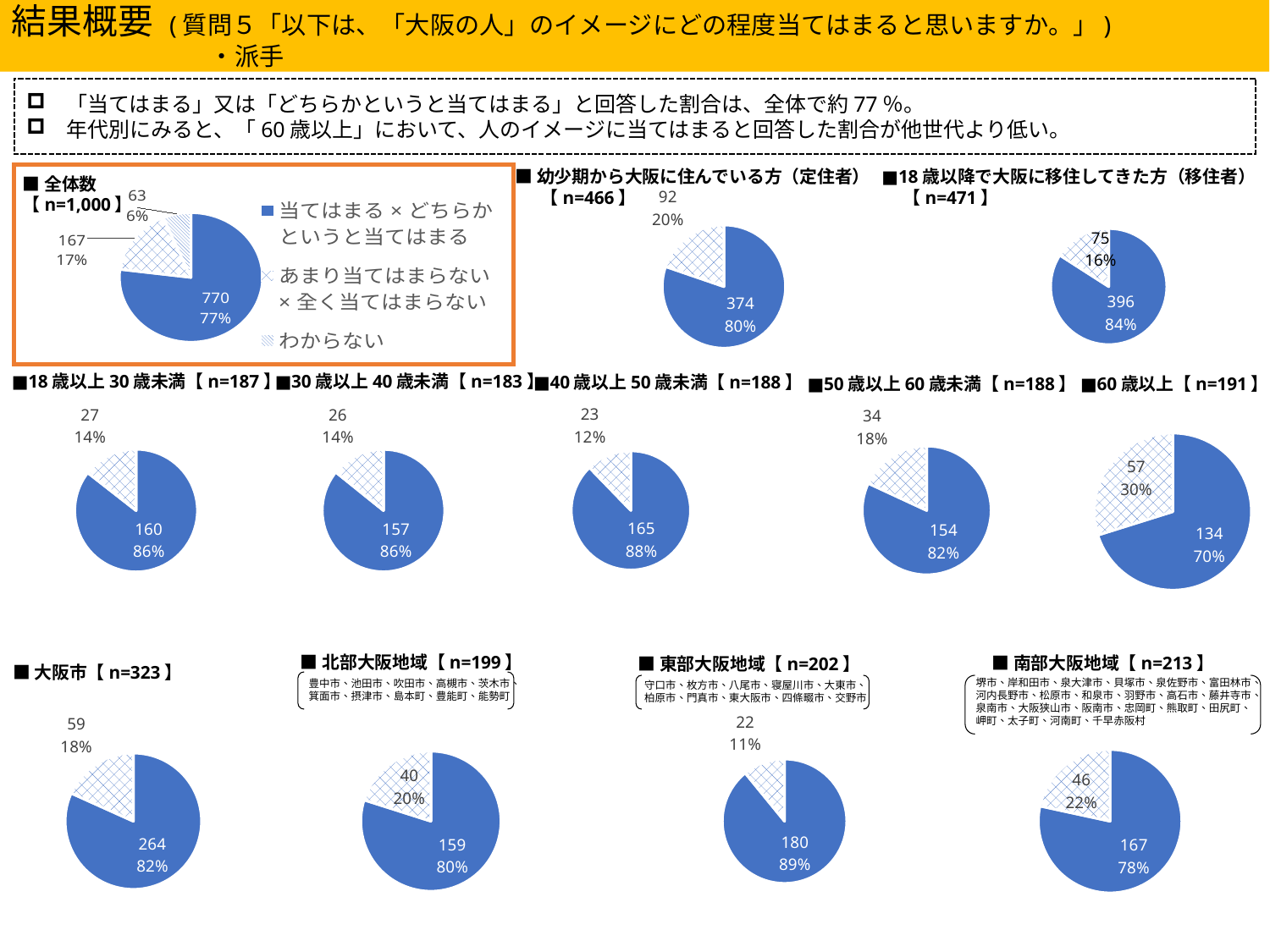
「幼少期から大阪に住んでいる方（定住者）【n=466】」の円グラフで、「当てはまる×どちらかというと当てはまる」の割合は何%ですか。 80% 「全体数【n=1,000】」の円グラフで、「あまり当てはまらない×全く当てはまらない」の割合は何%ですか。 17% 「全体数【n=1,000】」の円グラフの凡例には、いくつの項目がありますか。 3 「大阪市【n=323】」の円グラフで、「あまり当てはまらない×全く当てはまらない」の値はいくつですか。 59 「40歳以上50歳未満【n=188】」の円グラフで、「当てはまる×どちらかというと当てはまる」の値と「あまり当てはまらない×全く当てはまらない」の値の差はいくつですか。 142 「北部大阪地域【n=199】」の円グラフで、「当てはまる×どちらかというと当てはまる」の値はいくつですか。 159 「全体数【n=1,000】」の円グラフで、最も小さい区分の値はいくつですか。 63 「60歳以上【n=191】」の円グラフで、「当てはまる×どちらかというと当てはまる」の割合は何%ですか。 70% 「東部大阪地域【n=202】」と「南部大阪地域【n=213】」の円グラフで、「当てはまる×どちらかというと当てはまる」の割合が大きいのはどちらですか。 東部大阪地域 「全体数【n=1,000】」の円グラフで、「当てはまる×どちらかというと当てはまる」の値はいくつですか。 770 「18歳以降で大阪に移住してきた方（移住者）【n=471】」の円グラフで、「あまり当てはまらない×全く当てはまらない」の値はいくつですか。 75 このスライドのグラフはどの種類のグラフですか。 円グラフ